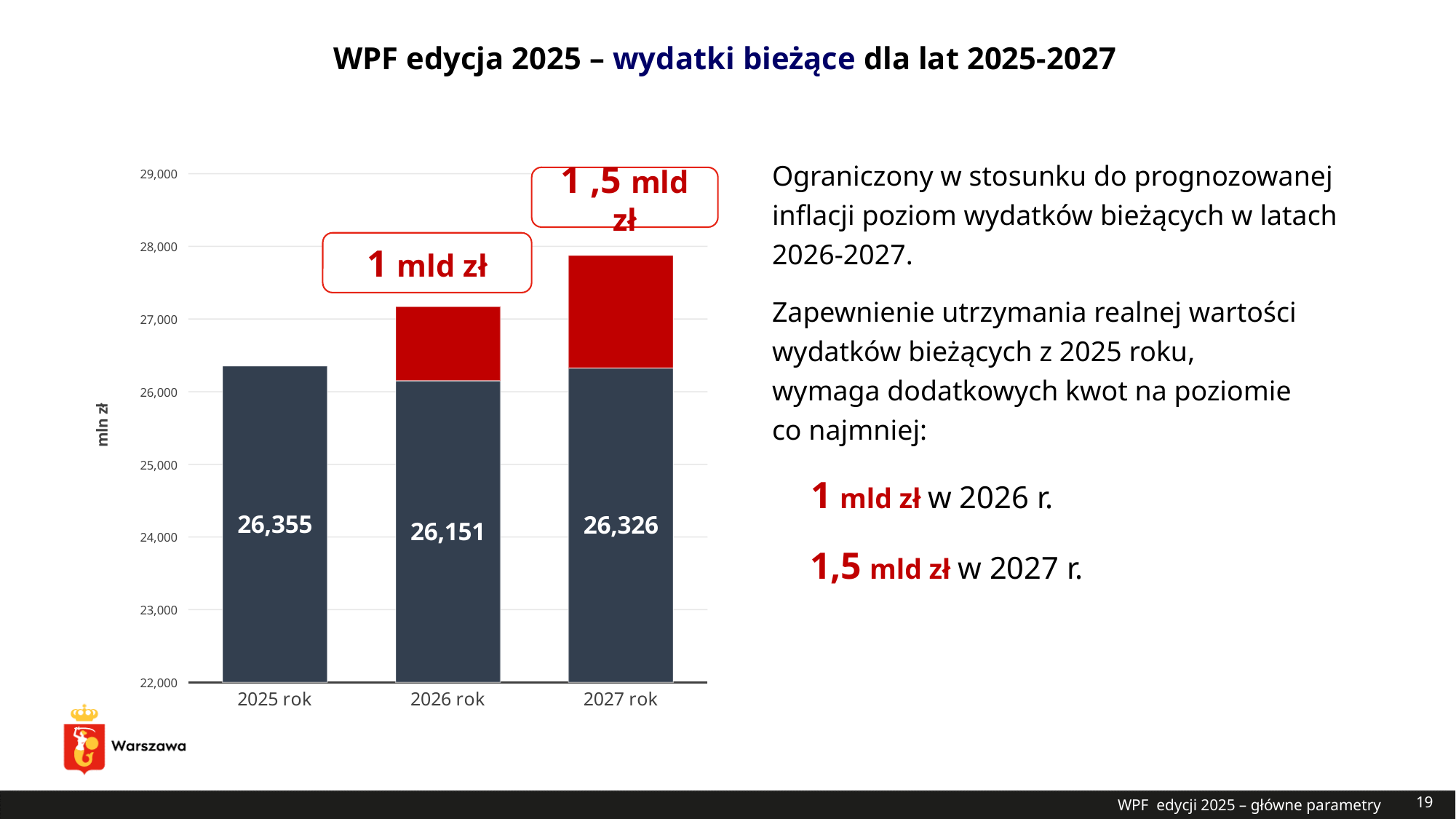
What is the difference between the printed values for 2025 rok and 2026 rok? 204 What is the difference between the printed values for 2025 rok and 2027 rok? 29 What is the value printed on the dark bar for 2026 rok? 26,151 Which printed dark-bar value is larger, 2025 rok or 2026 rok? 2025 rok What unit is given on the vertical axis label of the chart? mln zł Is the total height of the 2027 rok bar (including the red segment) greater or less than 28,000? less What is the value printed on the dark bar for 2027 rok? 26,326 Which year has the lowest printed value on its dark bar segment? 2026 rok What kind of chart is shown on the slide? bar chart How many years (categories) are shown on the x axis? 3 Which year has the highest printed value on its dark bar segment? 2025 rok What is the value printed on the dark bar for 2025 rok? 26,355